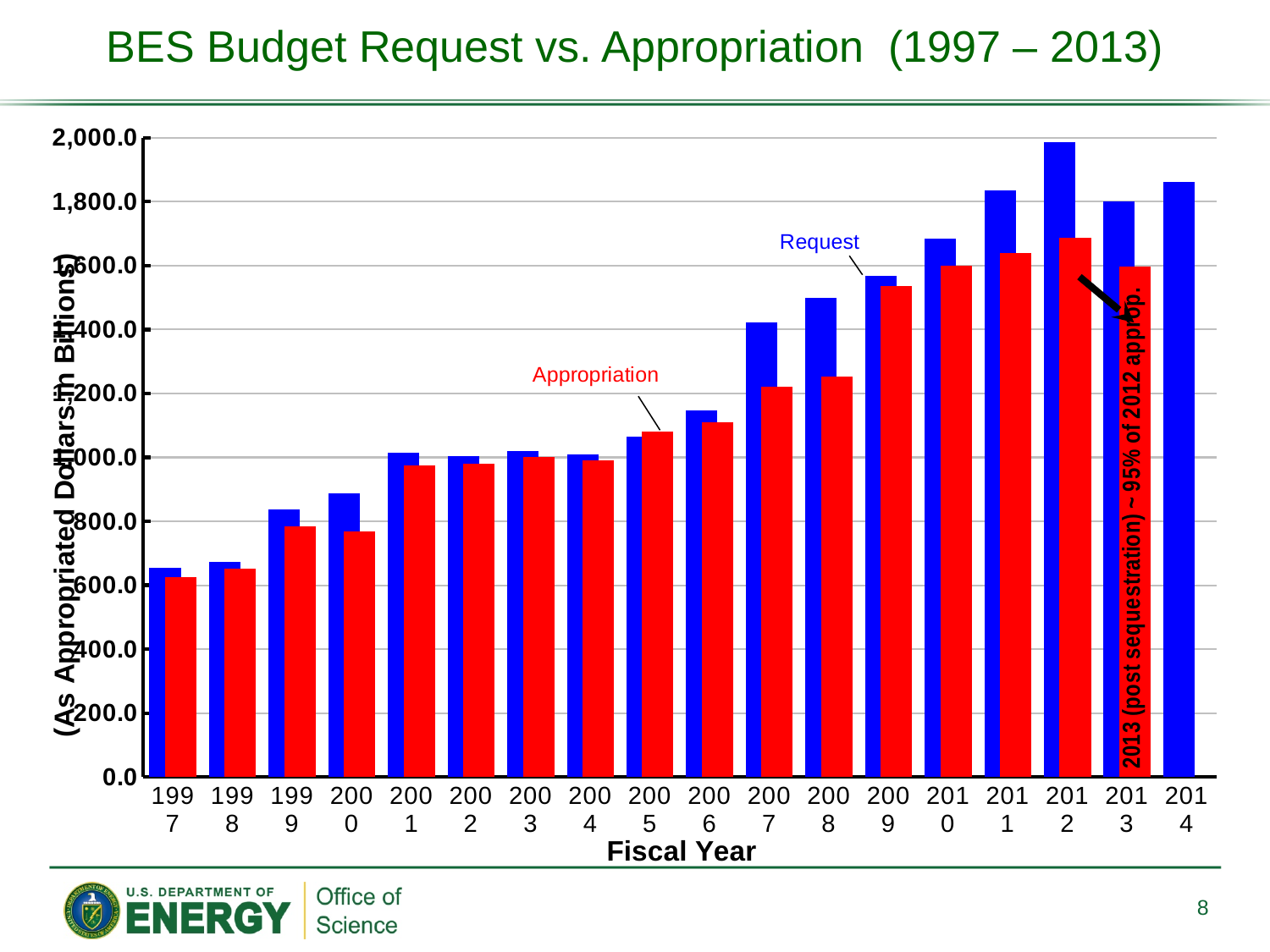
What kind of chart is shown on the slide? bar chart Is the Request value for 1997 greater or less than 800.0? less How many fiscal years are shown on the x axis? 18 Is the Request value for 2012 greater or less than 1,800.0? greater In which fiscal year is the Appropriation value lowest? 1997 What colour are the Request bars? blue Is the Request value for 2000 greater or less than 1,000.0? less How many data series are plotted in the chart? 2 Do the Request values generally rise or fall from 1997 to 2012? rise For fiscal year 2008, which is larger, the Request or the Appropriation? Request In which fiscal year is the Request value highest? 2012